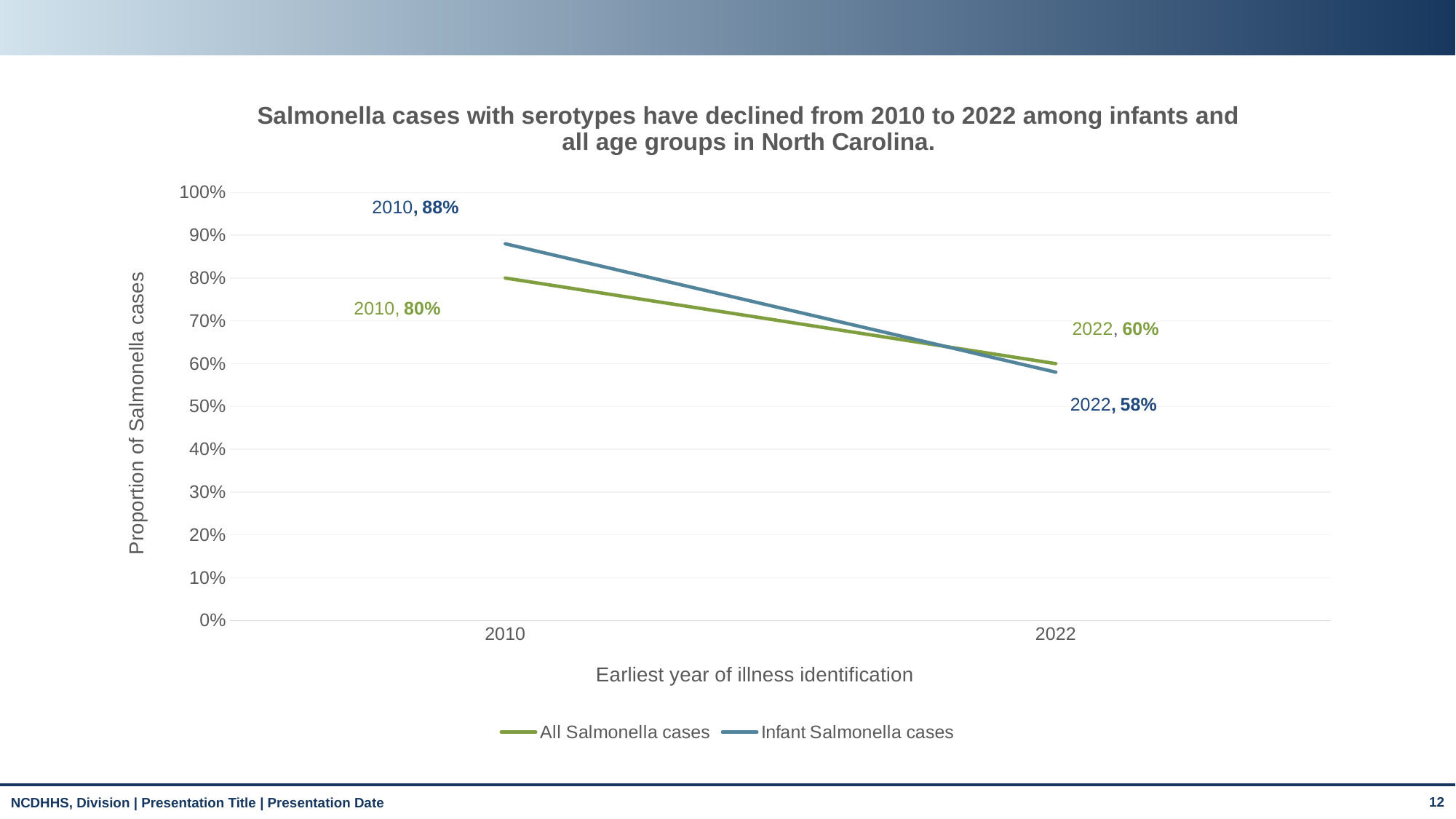
What is the difference between Infant Salmonella cases and All Salmonella cases in 2010? 8 percentage points What is the value for All Salmonella cases in 2010? 80% Do the values for All Salmonella cases rise or fall from 2010 to 2022? fall What is the value for Infant Salmonella cases in 2022? 58% In 2022, which series has the higher value, All Salmonella cases or Infant Salmonella cases? All Salmonella cases How many series does the legend list? 2 What kind of chart is shown on the slide? line chart By how many percentage points did Infant Salmonella cases decline from 2010 to 2022? 30 percentage points What is the label of the x axis? Earliest year of illness identification What is the value for Infant Salmonella cases in 2010? 88% What is the value for All Salmonella cases in 2022? 60% In 2010, which series has the higher value, All Salmonella cases or Infant Salmonella cases? Infant Salmonella cases